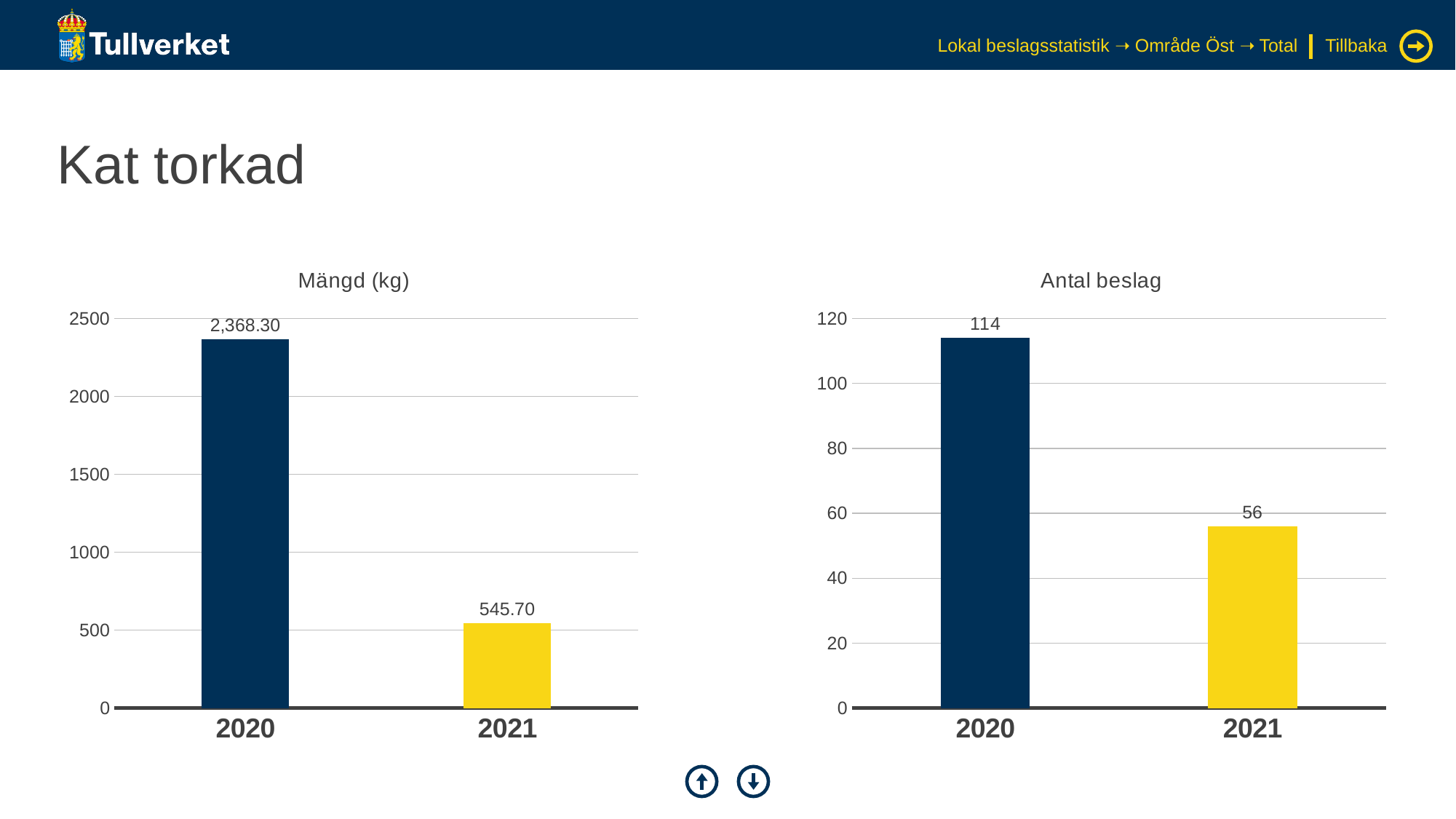
In the 'Mängd (kg)' chart, what is the difference between the values for 2020 and 2021? 1,822.60 In the 'Mängd (kg)' chart, is the value for 2021 greater or less than 1000? less In the 'Antal beslag' chart, which year has the lowest value? 2021 What kind of chart is the 'Mängd (kg)' chart? bar chart In the 'Antal beslag' chart, what is the difference between the values for 2020 and 2021? 58 How many categories are shown in the 'Antal beslag' chart? 2 In the 'Antal beslag' chart, what is the value for 2020? 114 In the 'Mängd (kg)' chart, which year has the highest value? 2020 In the 'Antal beslag' chart, what is the value for 2021? 56 In the 'Mängd (kg)' chart, what is the value for 2021? 545.70 In the 'Mängd (kg)' chart, what is the value for 2020? 2,368.30 In the 'Antal beslag' chart, is the value for 2020 greater or less than 100? greater